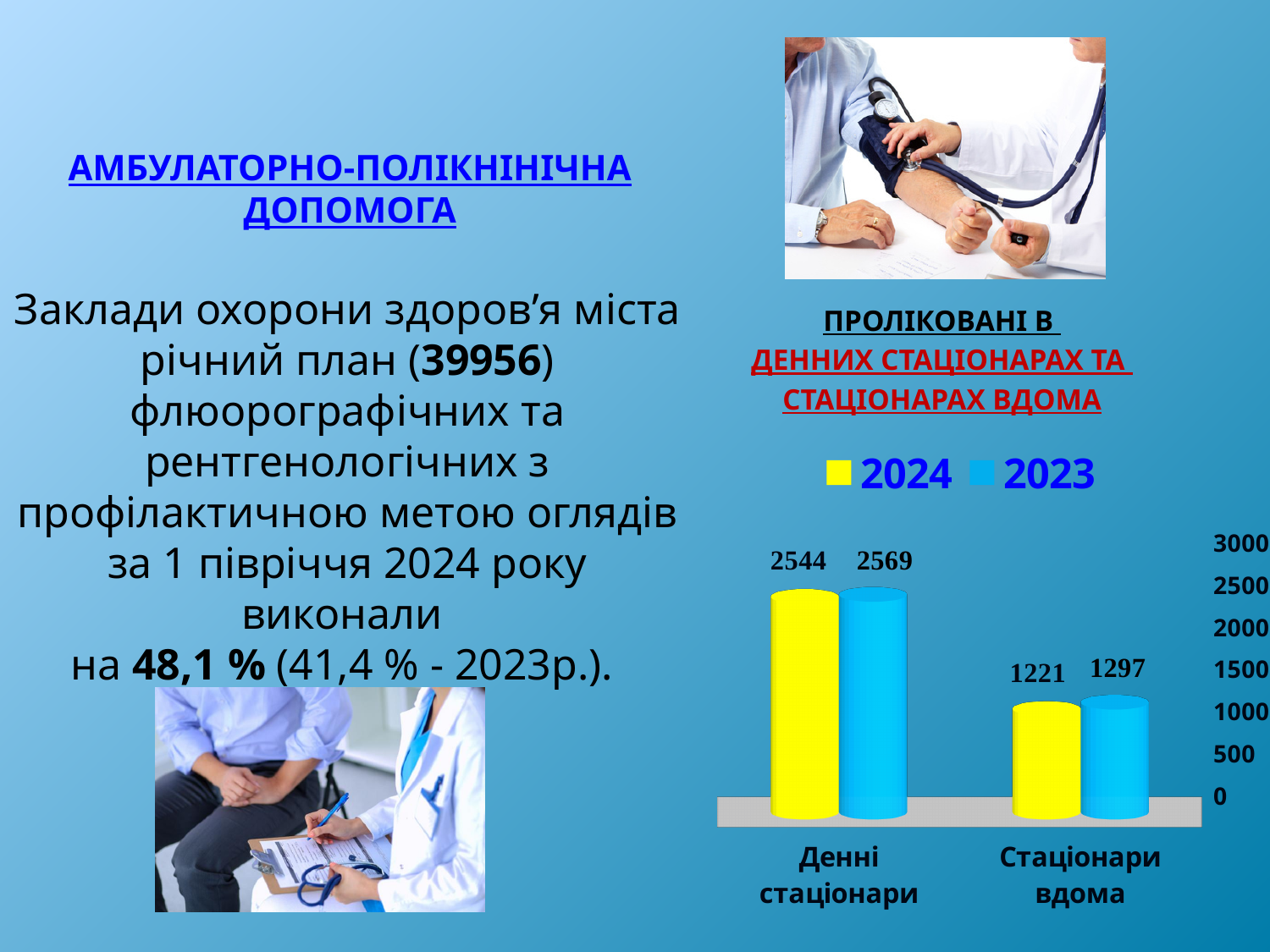
What is the difference between the 2023 and 2024 values for "Денні стаціонари"? 25 What is the value for 2024 in the "Денні стаціонари" category? 2544 How many categories are shown on the x axis of the chart? 2 What is the value for 2023 in the "Денні стаціонари" category? 2569 Which is larger: the 2024 value for "Денні стаціонари" or the 2024 value for "Стаціонари вдома"? Денні стаціонари Which category has the highest value for the 2023 series? Денні стаціонари How many series does the chart legend list? 2 What kind of chart is shown on the slide? Bar chart What is the value for 2024 in the "Стаціонари вдома" category? 1221 What is the value for 2023 in the "Стаціонари вдома" category? 1297 What is the difference between the 2023 and 2024 values for "Стаціонари вдома"? 76 Which category has the lowest value for the 2024 series? Стаціонари вдома